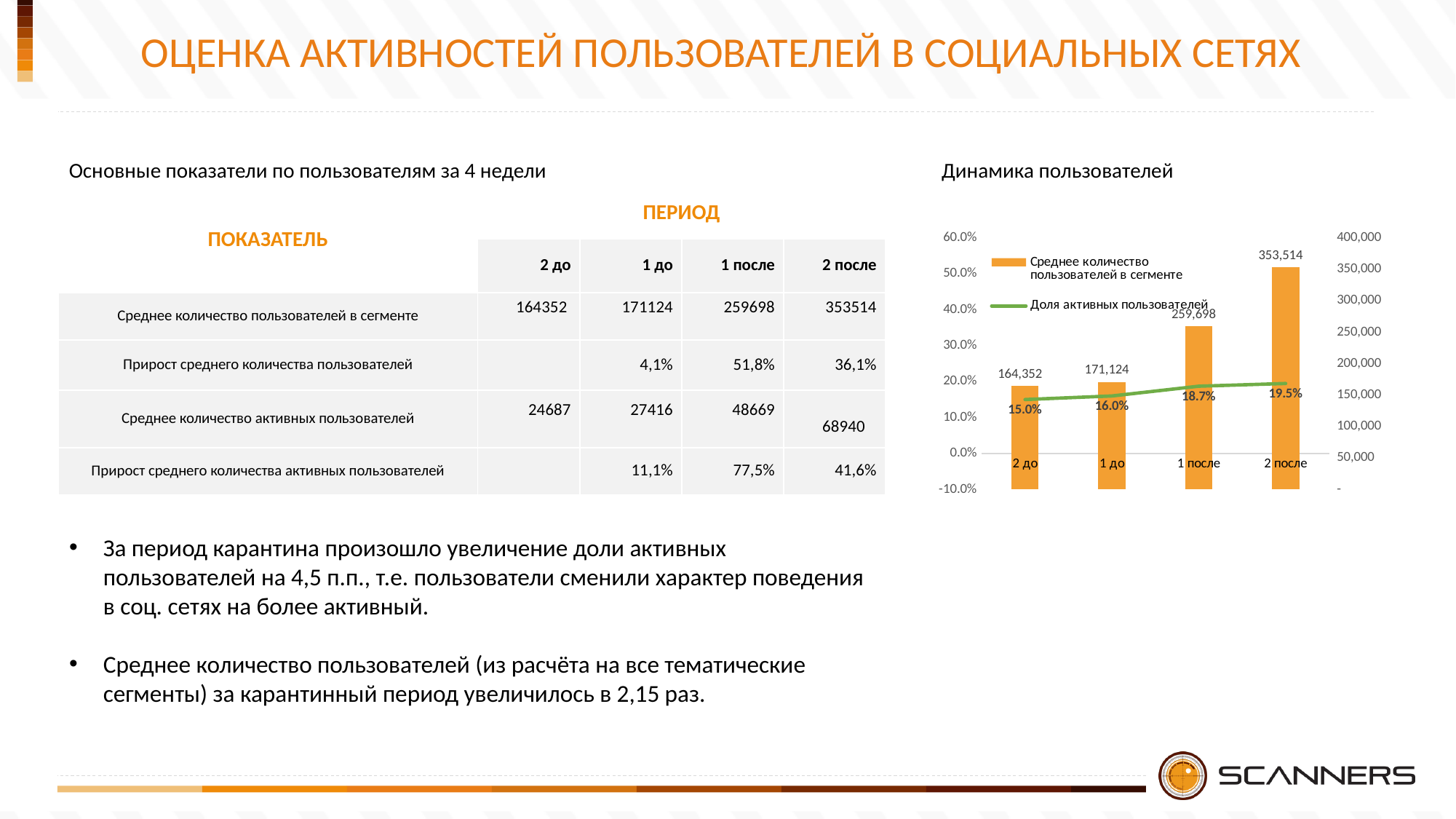
In the chart 'Динамика пользователей', does 'Доля активных пользователей' rise or fall from '2 до' to '2 после'? Rises In the chart 'Динамика пользователей', what is the difference in 'Доля активных пользователей' between '2 после' and '2 до'? 4.5 percentage points In the chart 'Динамика пользователей', what is the difference in 'Среднее количество пользователей в сегменте' between '2 после' and '1 после'? 93,816 In the chart 'Динамика пользователей', which period has the highest 'Среднее количество пользователей в сегменте'? 2 после In the chart 'Динамика пользователей', how many series does the legend list? 2 In the chart 'Динамика пользователей', what is the value of 'Доля активных пользователей' for '1 после'? 18.7% In the chart 'Динамика пользователей', what is the value of 'Среднее количество пользователей в сегменте' for '2 после'? 353,514 In the chart 'Динамика пользователей', which is larger: 'Среднее количество пользователей в сегменте' for '1 до' or for '1 после'? 1 после What kind of chart is 'Динамика пользователей'? Combination bar and line chart In the chart 'Динамика пользователей', what is the value of 'Среднее количество пользователей в сегменте' for '2 до'? 164,352 In the chart 'Динамика пользователей', which period has the lowest 'Доля активных пользователей'? 2 до In the chart 'Динамика пользователей', how many periods are shown on the x axis? 4